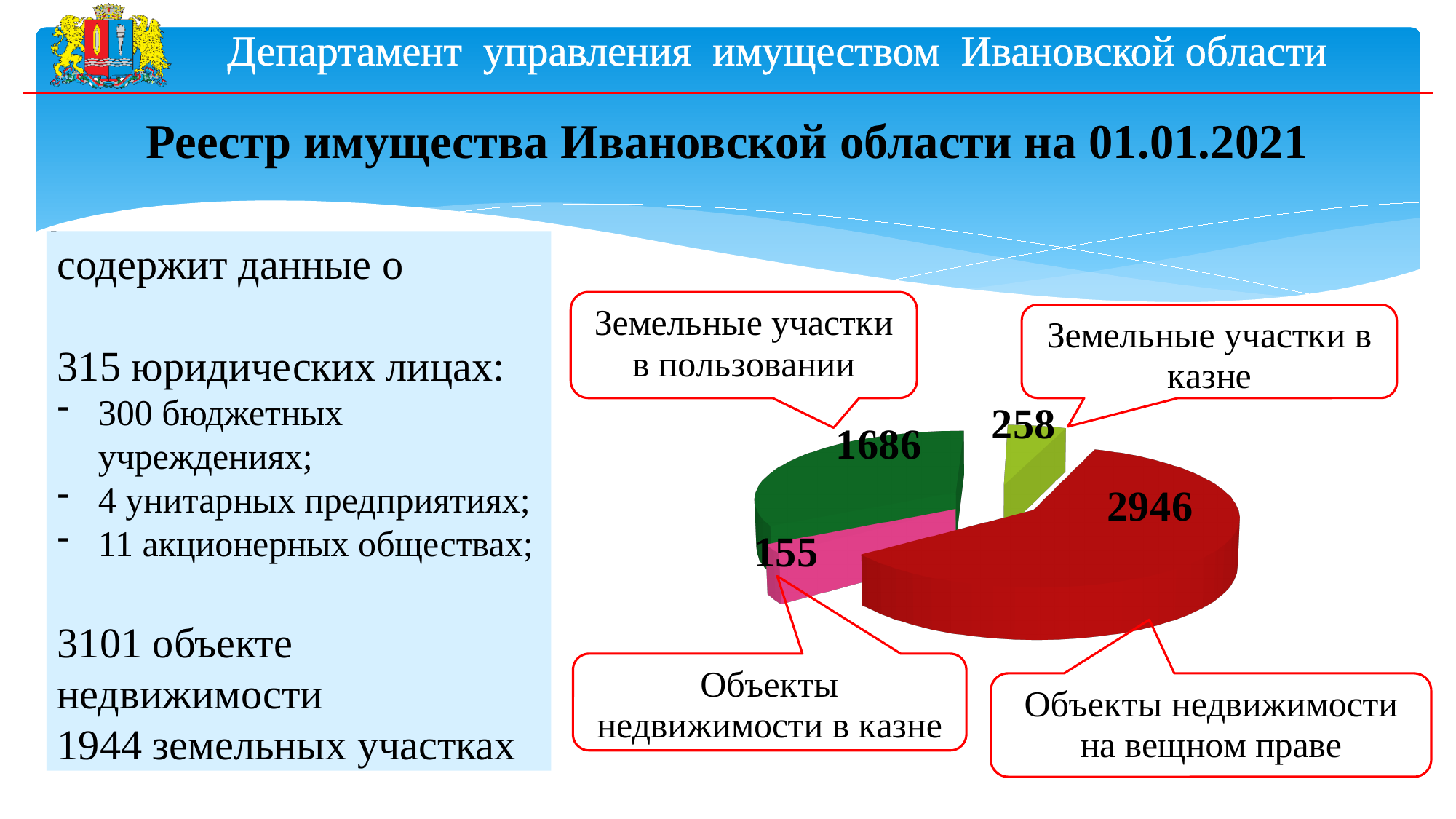
What colour is the slice for "Объекты недвижимости на вещном праве"? Red Which category has the smallest slice in the pie chart? Объекты недвижимости в казне How many slices does the pie chart have? 4 What is the value for "Объекты недвижимости в казне" in the pie chart? 155 What is the value for "Земельные участки в пользовании" in the pie chart? 1686 What is the value for "Объекты недвижимости на вещном праве" in the pie chart? 2946 What kind of chart is shown on the slide? Pie chart Which category has the largest slice in the pie chart? Объекты недвижимости на вещном праве Which is larger: "Земельные участки в казне" or "Объекты недвижимости в казне"? Земельные участки в казне What is the difference between "Земельные участки в казне" and "Объекты недвижимости в казне"? 103 What is the difference between "Объекты недвижимости на вещном праве" and "Земельные участки в пользовании"? 1260 What is the value for "Земельные участки в казне" in the pie chart? 258